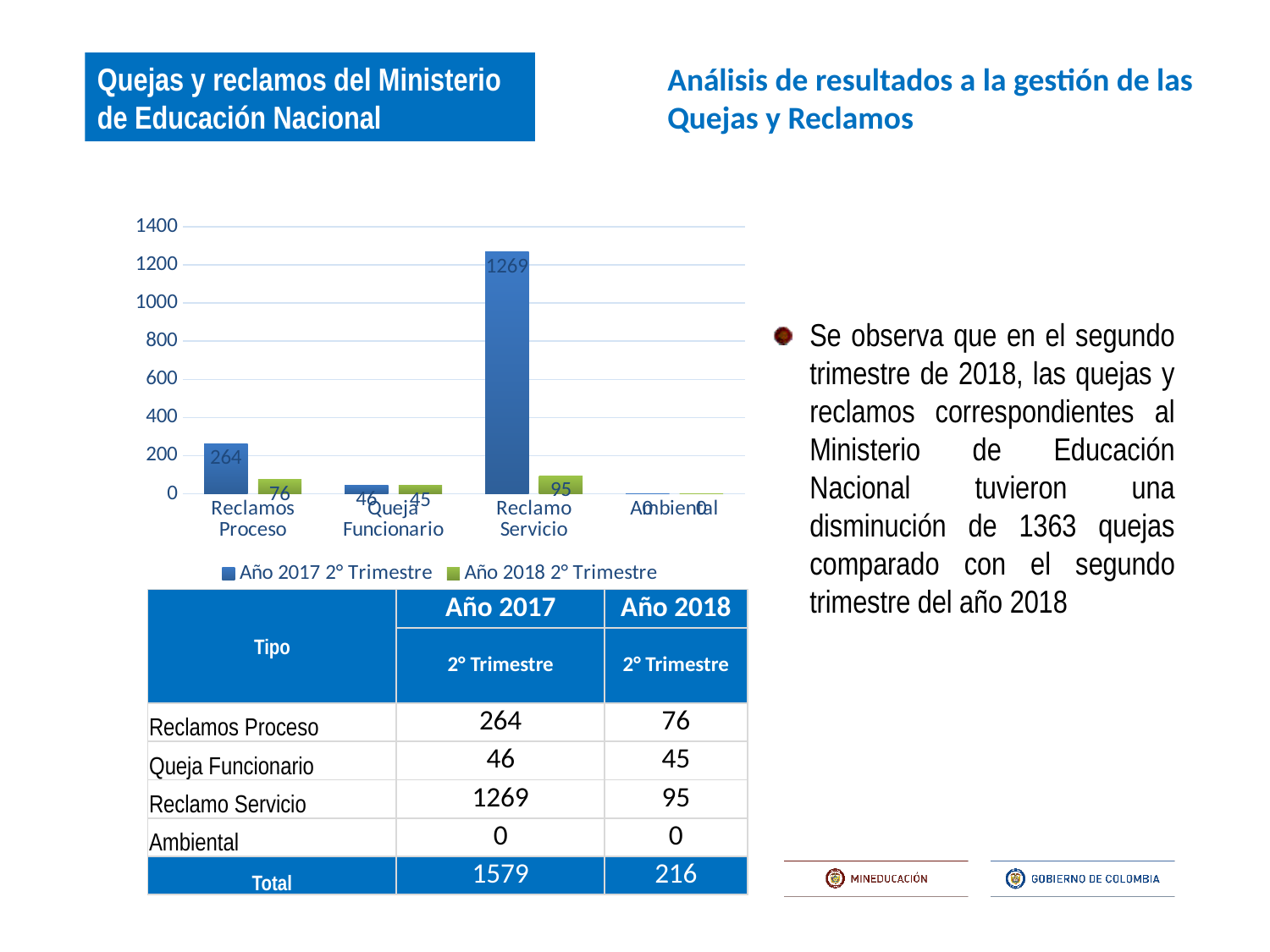
Is the Año 2017 2° Trimestre value for Reclamo Servicio greater or less than 1000? greater What is the value for Reclamos Proceso in the Año 2018 2° Trimestre series? 76 What is the value for Reclamo Servicio in the Año 2017 2° Trimestre series? 1269 What type of chart is shown on the slide? bar chart How many series does the chart legend list? 2 Which category has the lowest value in the Año 2018 2° Trimestre series? Ambiental Which is larger for Reclamos Proceso: the Año 2017 2° Trimestre value or the Año 2018 2° Trimestre value? Año 2017 2° Trimestre What is the value for Queja Funcionario in the Año 2017 2° Trimestre series? 46 How many categories are shown on the x axis of the chart? 4 What is the difference between the Año 2017 2° Trimestre and Año 2018 2° Trimestre values for Reclamo Servicio? 1174 Which category has the highest value in the Año 2017 2° Trimestre series? Reclamo Servicio What colour are the bars for the Año 2018 2° Trimestre series? green